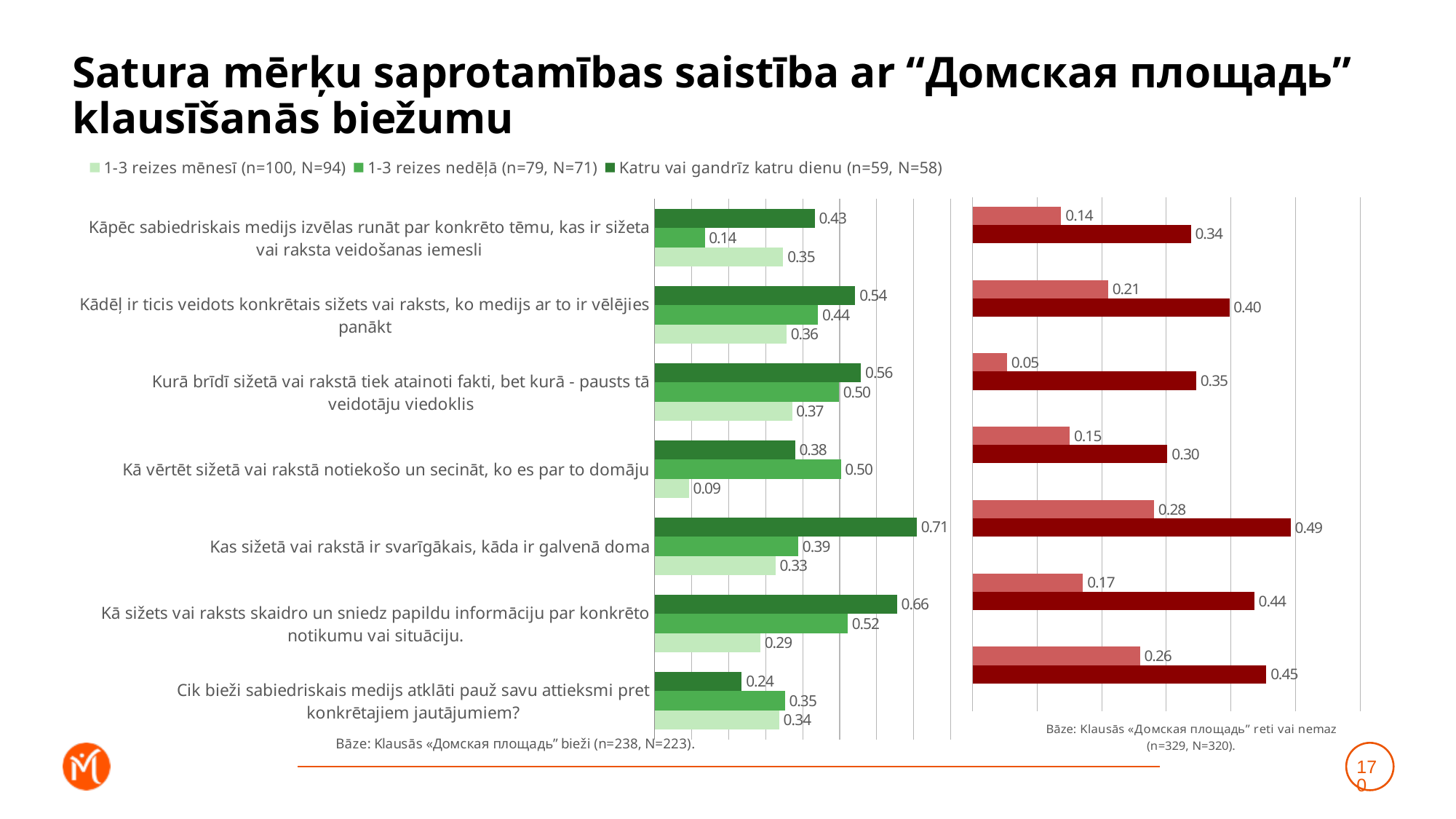
In the right (red) chart, what is the value of the dark red bar for the category "Kas sižetā vai rakstā ir svarīgākais, kāda ir galvenā doma"? 0.49 How many series does the legend of the left (green) chart list? 3 In the left (green) chart, what is the difference between the "Katru vai gandrīz katru dienu" and "1-3 reizes mēnesī" values for "Kas sižetā vai rakstā ir svarīgākais, kāda ir galvenā doma"? 0.38 In the left (green) chart, what is the value for "1-3 reizes mēnesī" for the category "Kā vērtēt sižetā vai rakstā notiekošo un secināt, ko es par to domāju"? 0.09 According to the note under the right (red) chart, what is the base (Bāze) for that chart? Klausās «Домская площадь» reti vai nemaz (n=329, N=320) How many categories are shown in the left (green) chart? 7 In the left (green) chart, which category has the lowest value for "1-3 reizes mēnesī"? Kā vērtēt sižetā vai rakstā notiekošo un secināt, ko es par to domāju In the left (green) chart, for "Cik bieži sabiedriskais medijs atklāti pauž savu attieksmi pret konkrētajiem jautājumiem?", which is larger: the "1-3 reizes nedēļā" value or the "Katru vai gandrīz katru dienu" value? 1-3 reizes nedēļā In the left (green) chart, what is the value for "Katru vai gandrīz katru dienu" for the category "Kas sižetā vai rakstā ir svarīgākais, kāda ir galvenā doma"? 0.71 In the left (green) chart, what is the value for "1-3 reizes nedēļā" for the category "Kā sižets vai raksts skaidro un sniedz papildu informāciju par konkrēto notikumu vai situāciju."? 0.52 What kind of chart is the left (green) chart? Bar chart In the left (green) chart, which category has the highest value for "Katru vai gandrīz katru dienu"? Kas sižetā vai rakstā ir svarīgākais, kāda ir galvenā doma